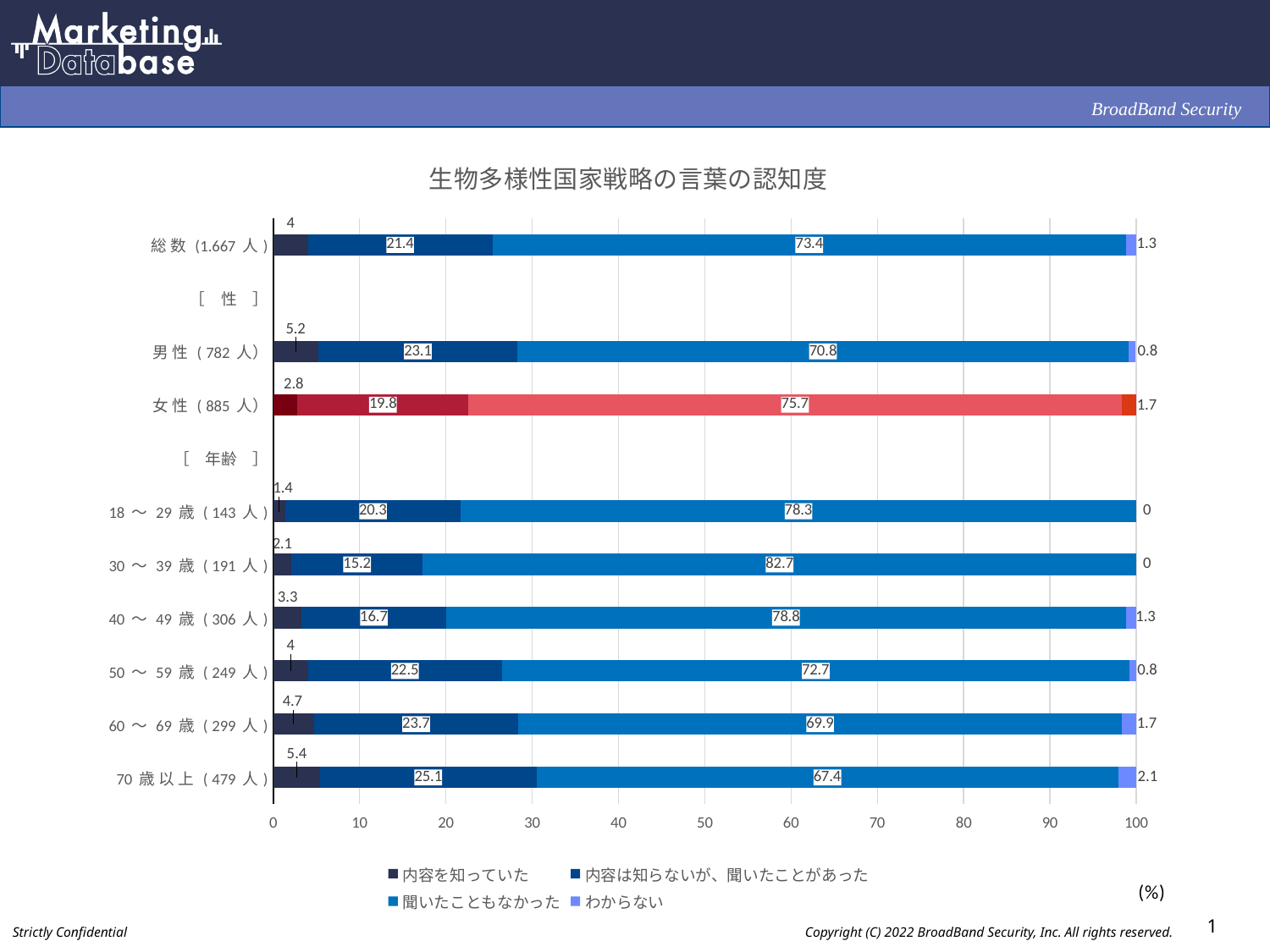
What type of chart is shown on the slide? Stacked bar chart Which is larger, the 内容は知らないが、聞いたことがあった value for 60～69歳 (299人) or for 50～59歳 (249人)? 60～69歳 (299人) Which age group has the lowest value for 内容を知っていた? 18～29歳 (143人) How many series does the legend list? 4 What is the value of 聞いたこともなかった for 総数 (1,667人)? 73.4 What is the value of 内容を知っていた for 男性 (782人)? 5.2 What is the difference between the 聞いたこともなかった values for 女性 (885人) and 男性 (782人)? 4.9 What is the value of わからない for 70歳以上 (479人)? 2.1 Which age group has the highest value for 聞いたこともなかった? 30～39歳 (191人) What is the title of the chart? 生物多様性国家戦略の言葉の認知度 How many categories (bars) are plotted in the chart? 9 What is the value of 内容は知らないが、聞いたことがあった for 女性 (885人)? 19.8